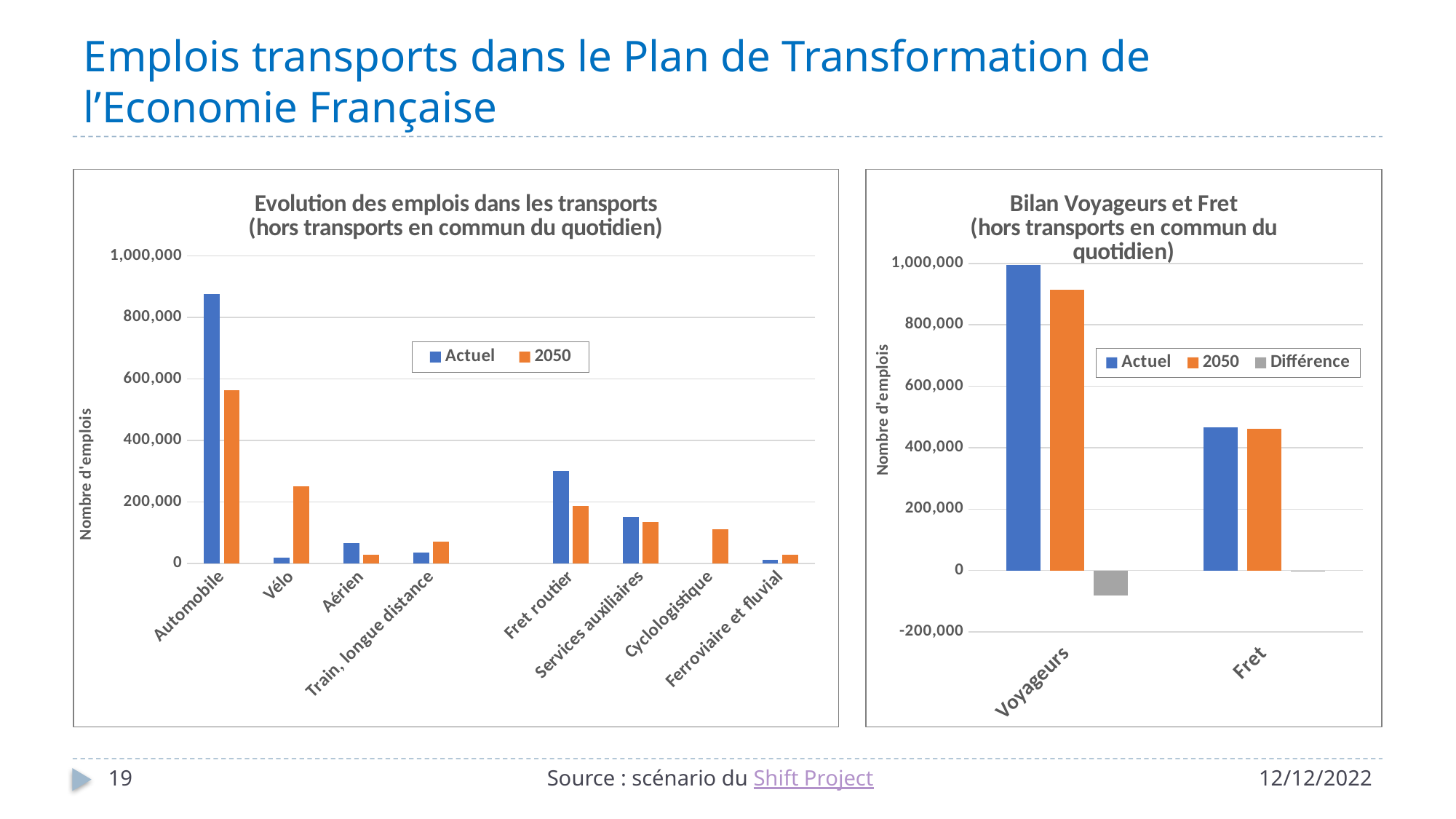
In the chart titled 'Bilan Voyageurs et Fret', how many categories are shown on the x axis? 2 In the chart titled 'Evolution des emplois dans les transports', is the 'Actuel' value for Fret routier greater or less than 400,000? less In the chart titled 'Evolution des emplois dans les transports', how many categories are shown on the x axis? 8 In the chart titled 'Evolution des emplois dans les transports', what kind of chart is shown? bar chart In the chart titled 'Evolution des emplois dans les transports', is the 'Actuel' value for Automobile greater or less than 800,000? greater In the chart titled 'Evolution des emplois dans les transports', which category has the highest 'Actuel' value? Automobile In the chart titled 'Bilan Voyageurs et Fret', how many series does the legend list? 3 In the chart titled 'Evolution des emplois dans les transports', how many series does the legend list? 2 In the chart titled 'Evolution des emplois dans les transports', which is larger for Vélo: the 'Actuel' value or the '2050' value? 2050 In the chart titled 'Evolution des emplois dans les transports', is the '2050' value for Vélo greater or less than 200,000? greater In the chart titled 'Bilan Voyageurs et Fret', which category has the larger 'Actuel' value: Voyageurs or Fret? Voyageurs In the chart titled 'Bilan Voyageurs et Fret', what is the label of the vertical axis? Nombre d'emplois